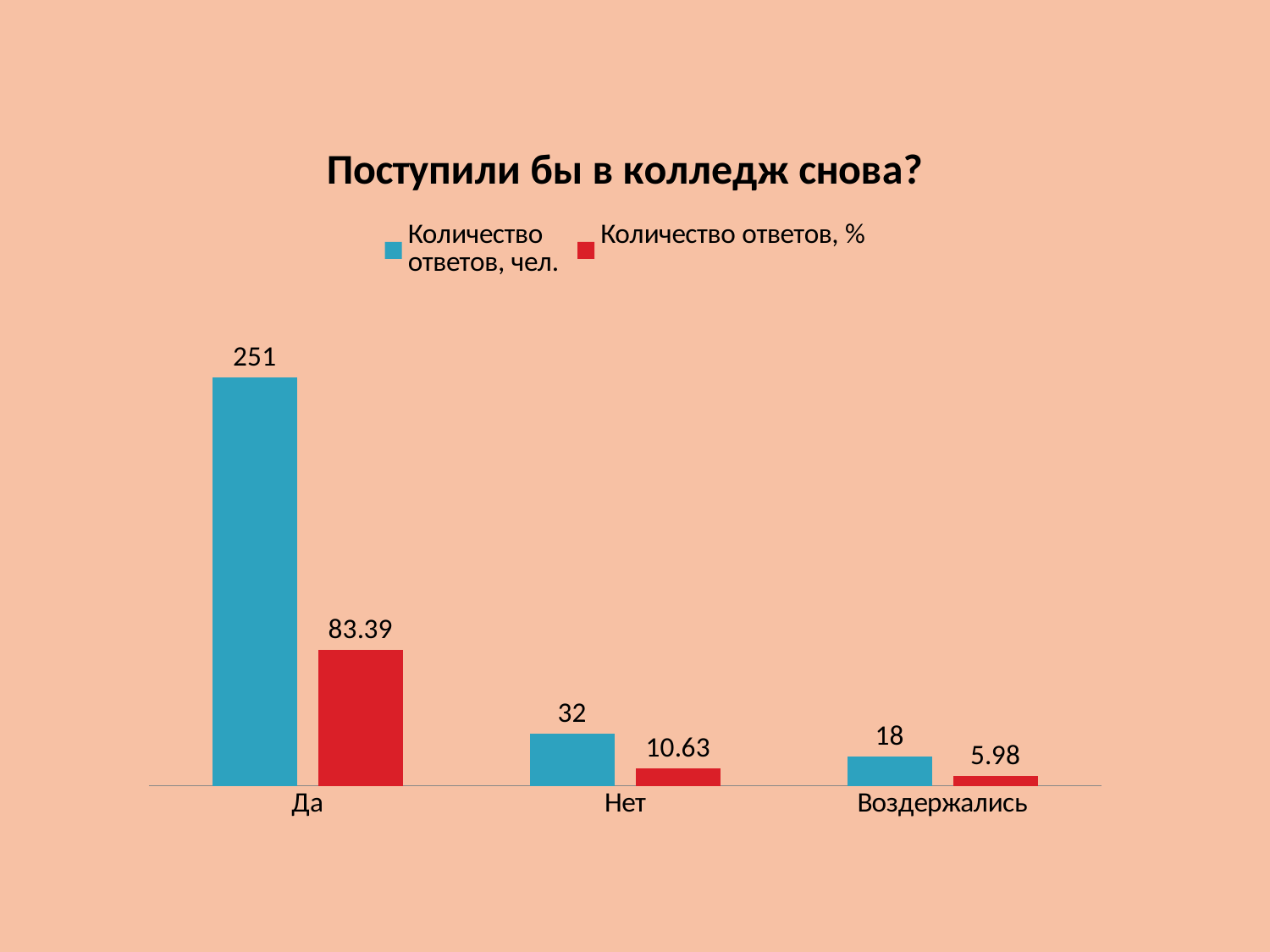
What kind of chart is shown on the slide? Bar chart What is the value of "Количество ответов, %" for "Нет"? 10.63 What is the value of "Количество ответов, %" for "Да"? 83.39 Which is larger: the "Количество ответов, чел." value for "Нет" or for "Воздержались"? Нет How many series does the legend list? 2 What is the difference between the "Количество ответов, чел." values for "Да" and "Нет"? 219 Which category has the lowest value for "Количество ответов, %"? Воздержались What is the value of "Количество ответов, чел." for "Воздержались"? 18 How many categories are shown on the x axis? 3 What is the value of "Количество ответов, чел." for "Да"? 251 What is the title of the chart? Поступили бы в колледж снова? Which category has the highest value for "Количество ответов, чел."? Да